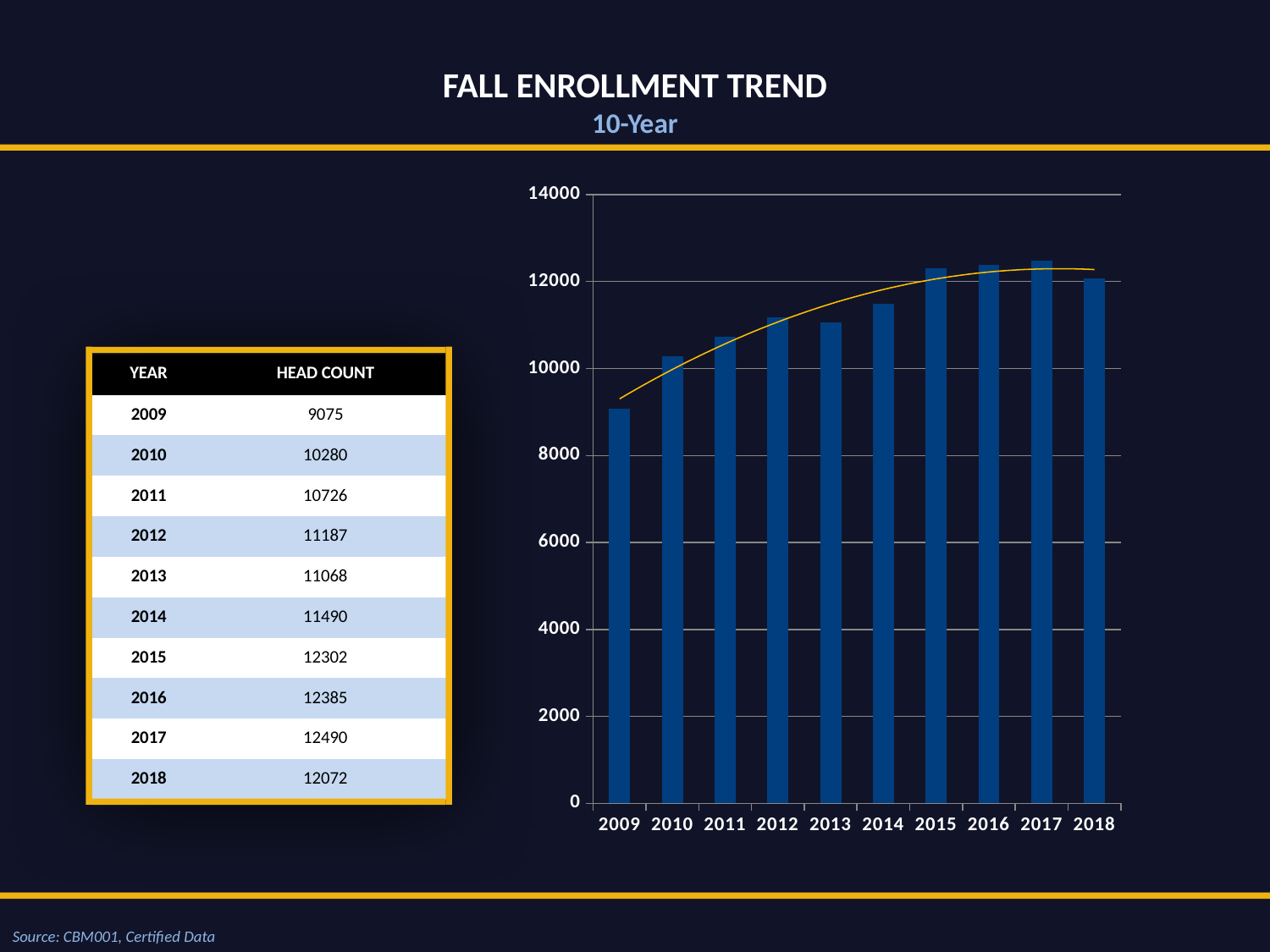
What kind of chart is shown on the slide? bar chart What is the difference between the head count in 2017 and in 2009? 3415 Is the value for 2009 greater or less than 10000? less What is the head count for 2018? 12072 Which year has the lowest head count? 2009 Is the value for 2013 greater or less than 12000? less Which year has the highest head count? 2017 Does the head count rise or fall from 2009 to 2015? rise Which year has the larger head count, 2012 or 2013? 2012 Is the value for 2015 greater or less than 12000? greater How many years are plotted on the x axis of the chart? 10 What is the head count for 2014? 11490